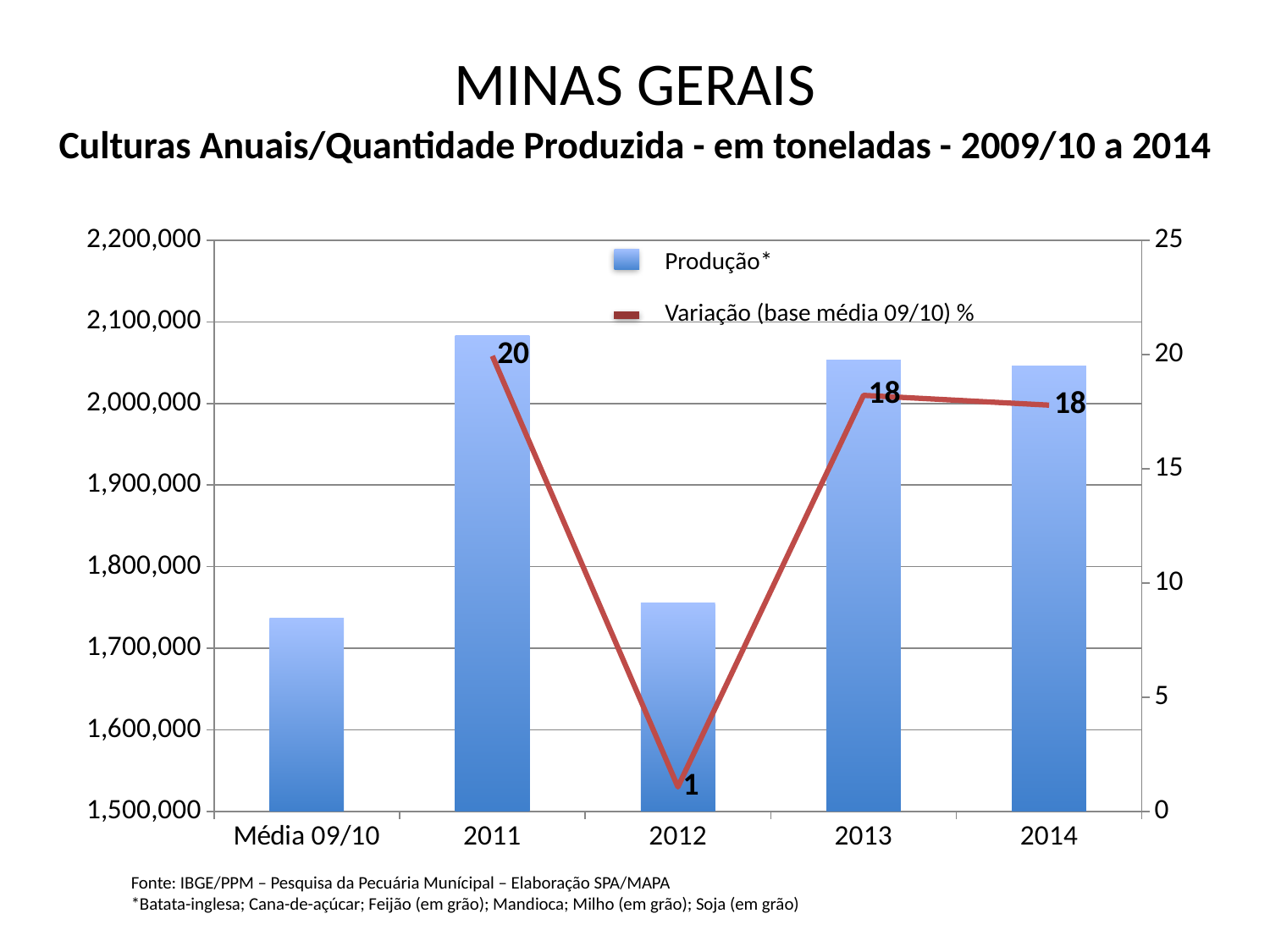
Is the Produção* value for 2011 greater or less than 2,000,000? greater Is the Produção* value for Média 09/10 greater or less than 1,800,000? less Which has the larger Produção* bar, 2012 or 2013? 2013 What is the value of Variação (base média 09/10) % for 2011? 20 How many series does the legend list? 2 What is the difference between the Variação values for 2011 and 2012? 19 Which category has the tallest Produção* bar? 2011 Which year has the highest Variação (base média 09/10) % value? 2011 Which year has the lowest Variação (base média 09/10) % value? 2012 What is the value of Variação (base média 09/10) % for 2013? 18 What is the value of Variação (base média 09/10) % for 2012? 1 How many categories are shown on the x axis? 5